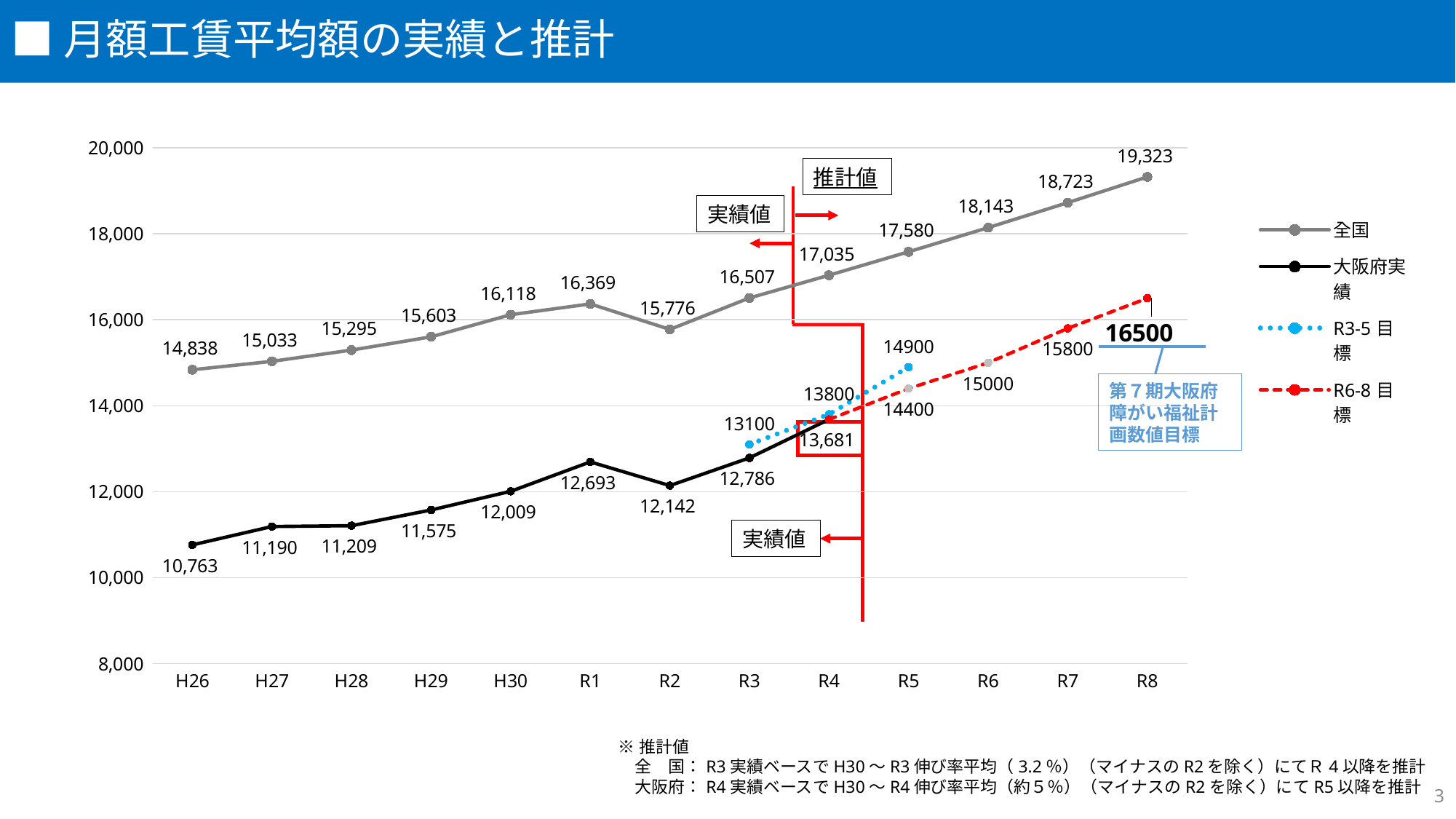
What is the value of R6-8目標 for R8? 16500 What kind of chart is shown on the slide? line chart How many categories are on the x axis? 13 In which year is the 全国 series highest? R8 In which year is the 大阪府実績 series lowest? H26 Which is larger for 全国: the value for R1 or the value for R2? R1 What is the value of 全国 for H26? 14,838 What is the value of R3-5目標 for R5? 14900 What is the value of 全国 for R8? 19,323 How many series does the legend list? 4 What is the value of 大阪府実績 for R4? 13,681 What is the difference between the 全国 value for R8 and for H26? 4,485